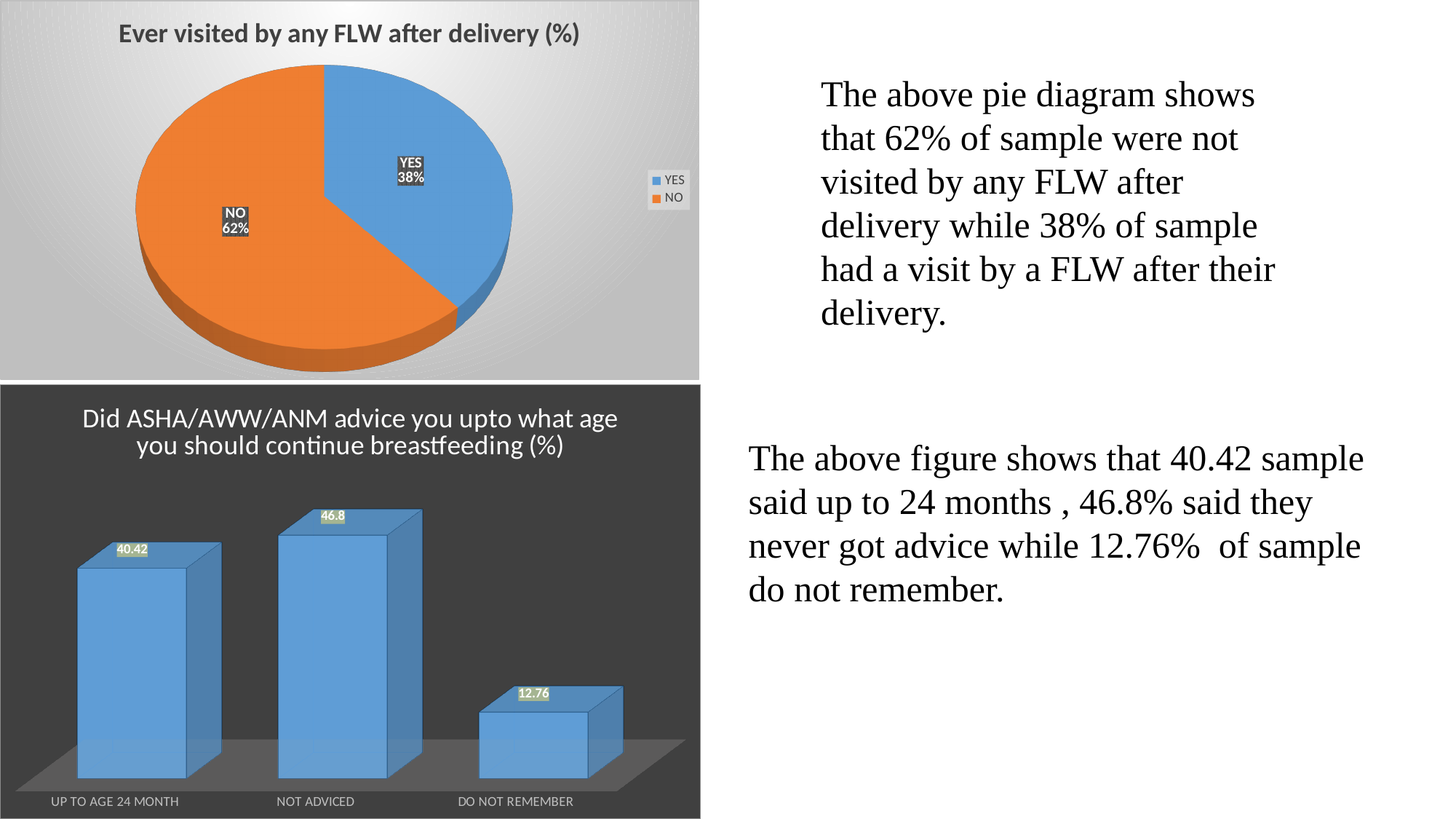
In the chart titled "Did ASHA/AWW/ANM advice you upto what age you should continue breastfeeding (%)", what is the value for UP TO AGE 24 MONTH? 40.42 What kind of chart is the chart titled "Ever visited by any FLW after delivery (%)"? Pie chart In the chart titled "Ever visited by any FLW after delivery (%)", what share of the pie is labelled YES? 38% In the chart titled "Ever visited by any FLW after delivery (%)", which slice is larger, YES or NO? NO In the chart titled "Did ASHA/AWW/ANM advice you upto what age you should continue breastfeeding (%)", which category has the highest value? NOT ADVICED How many entries does the legend list in the chart titled "Ever visited by any FLW after delivery (%)"? 2 In the chart titled "Did ASHA/AWW/ANM advice you upto what age you should continue breastfeeding (%)", what is the difference between the values for NOT ADVICED and DO NOT REMEMBER? 34.04 In the chart titled "Ever visited by any FLW after delivery (%)", what colour is the NO slice? Orange In the chart titled "Did ASHA/AWW/ANM advice you upto what age you should continue breastfeeding (%)", what is the value for NOT ADVICED? 46.8 In the chart titled "Ever visited by any FLW after delivery (%)", what share of the pie is labelled NO? 62% In the chart titled "Did ASHA/AWW/ANM advice you upto what age you should continue breastfeeding (%)", which category has the lowest value? DO NOT REMEMBER How many categories are shown in the chart titled "Did ASHA/AWW/ANM advice you upto what age you should continue breastfeeding (%)"? 3